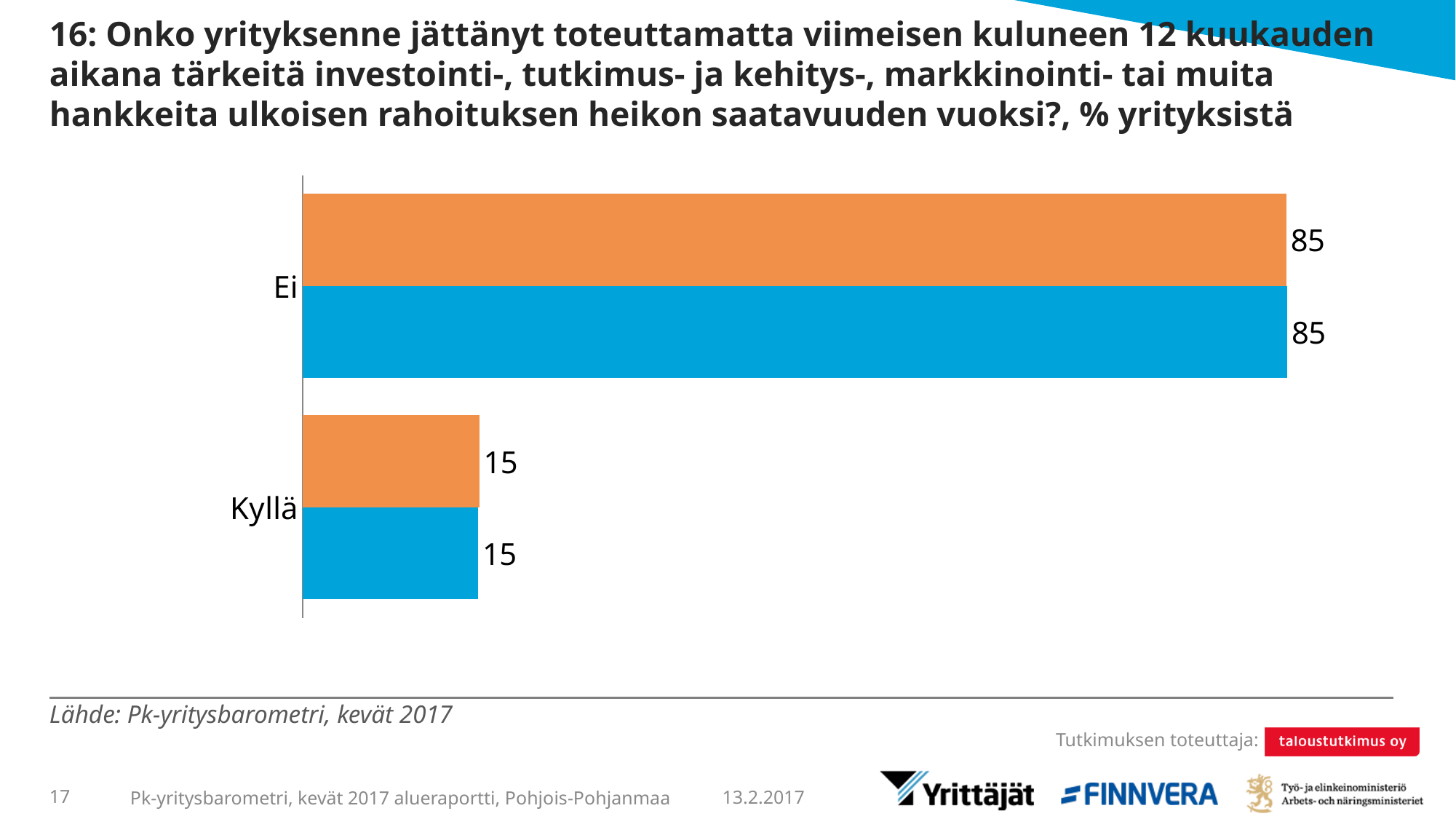
What is the value of the orange bar for "Kyllä"? 15 What is the total of the orange and blue bar values for "Kyllä"? 30 What source is cited below the chart? Pk-yritysbarometri, kevät 2017 What type of chart is shown on the slide? Bar chart What is the value of the orange bar for "Ei"? 85 Which is larger, the blue bar for "Ei" or the blue bar for "Kyllä"? Ei Which category has the lowest value in the chart? Kyllä How many categories are shown on the chart's axis? 2 Which category has the highest value in the chart? Ei What is the value of the blue bar for "Kyllä"? 15 What is the value of the blue bar for "Ei"? 85 What is the difference between the orange bar values for "Ei" and "Kyllä"? 70